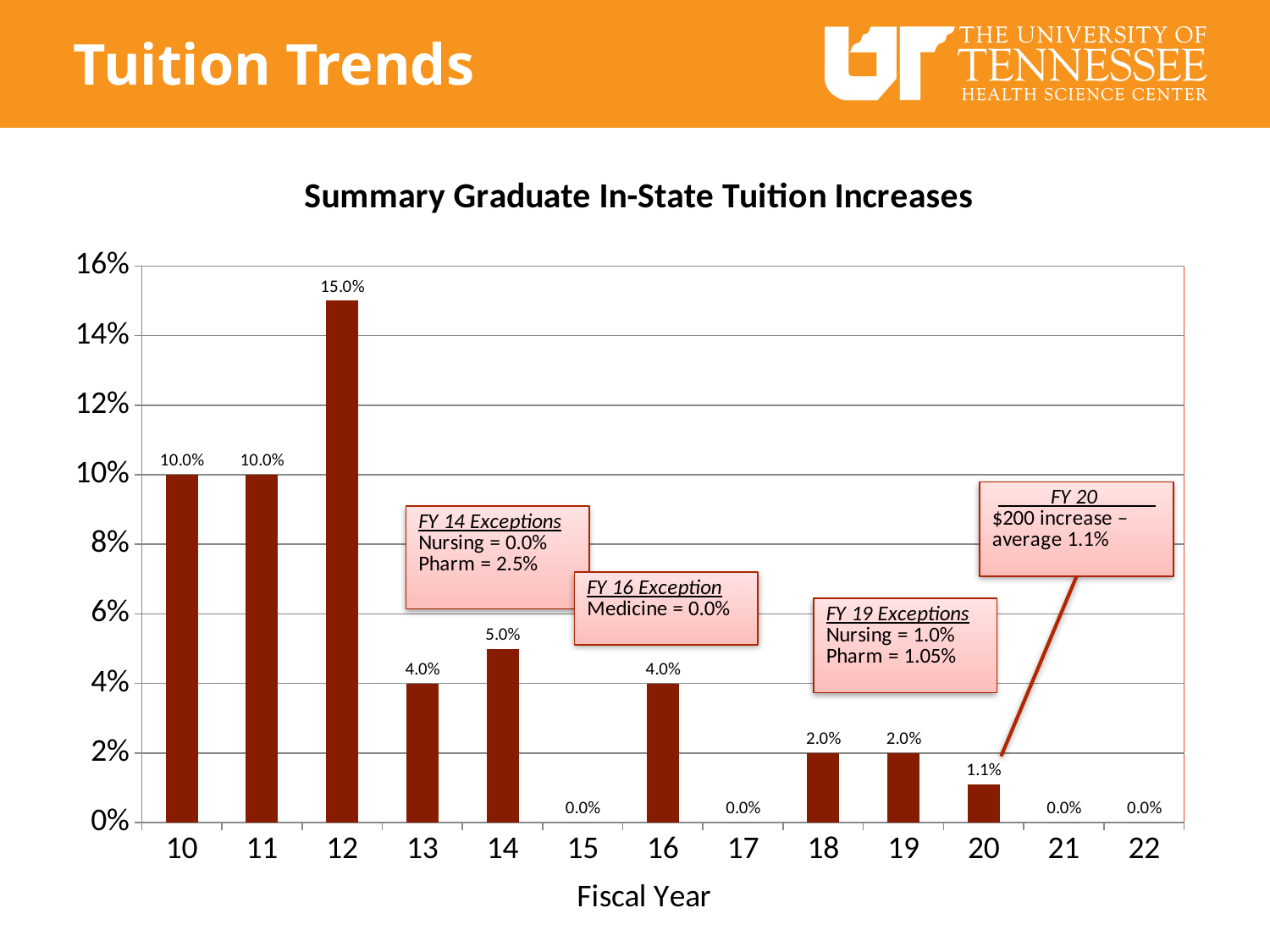
How many fiscal years are shown on the x axis? 13 What is the difference between the tuition increase in fiscal year 12 and fiscal year 13? 11.0% Which is larger, the tuition increase for fiscal year 14 or fiscal year 18? Fiscal year 14 Do the tuition increases generally rise or fall from fiscal year 12 to fiscal year 22? Fall What kind of chart is shown on the slide? Bar chart What is the tuition increase for fiscal year 14? 5.0% What is the tuition increase for fiscal year 20? 1.1% Is the value for fiscal year 12 greater or less than 14%? greater What is the tuition increase for fiscal year 12? 15.0% Which fiscal year has the highest tuition increase? 12 What is the title of the chart? Summary Graduate In-State Tuition Increases What is the x axis label of the chart? Fiscal Year